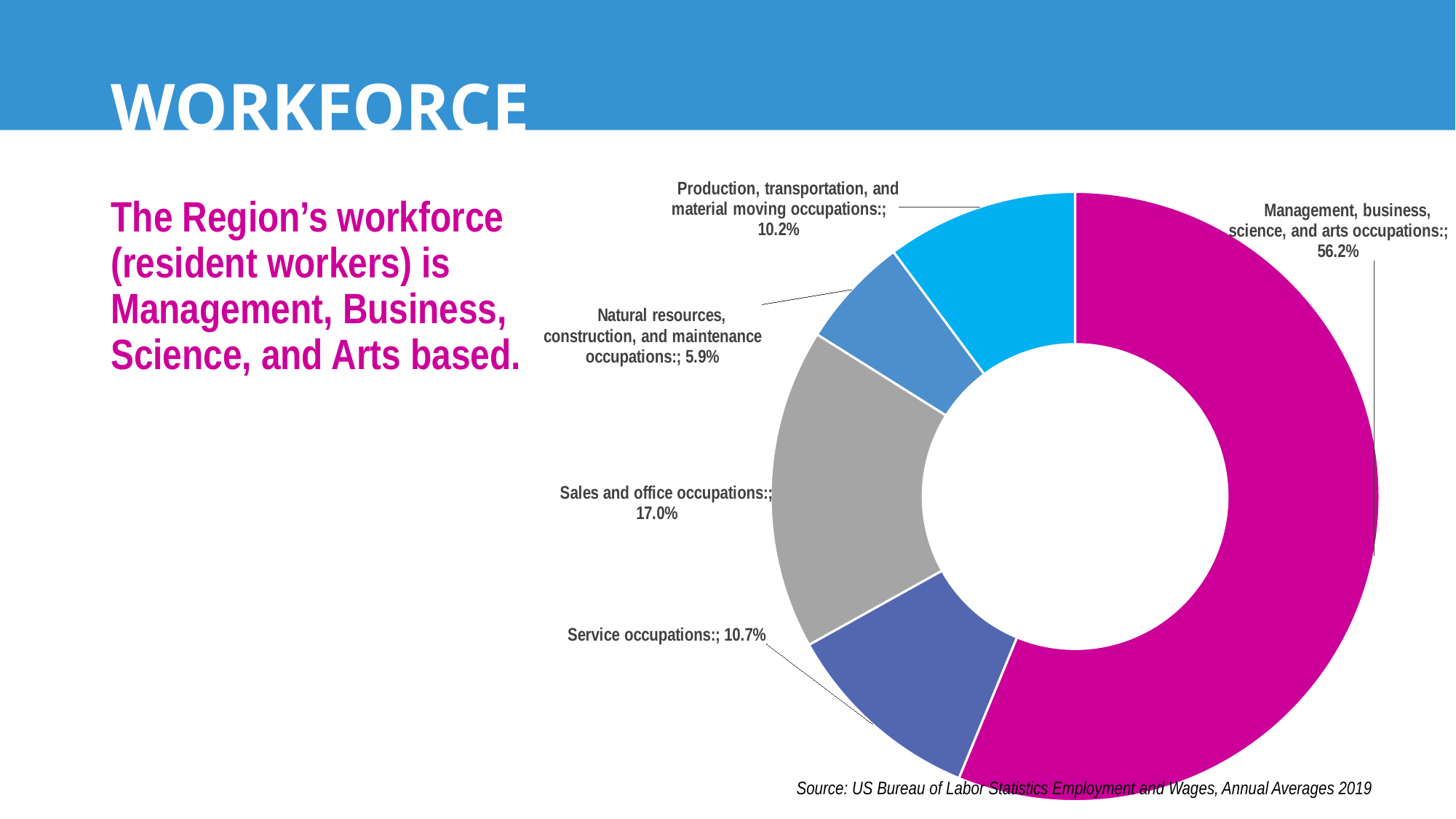
Which occupation group has the largest share of the workforce? Management, business, science, and arts occupations What share of the workforce is in Natural resources, construction, and maintenance occupations? 5.9% Which occupation group has the smallest share of the workforce? Natural resources, construction, and maintenance occupations What share of the workforce is in Service occupations? 10.7% Which has a larger share: Sales and office occupations or Service occupations? Sales and office occupations What kind of chart is shown on the slide? Doughnut (pie) chart What share of the workforce is in Sales and office occupations? 17.0% What share of the workforce is in Management, business, science, and arts occupations? 56.2% What is the difference in percentage points between Management, business, science, and arts occupations and Sales and office occupations? 39.2 What share of the workforce is in Production, transportation, and material moving occupations? 10.2% What colour is the slice for Sales and office occupations? Grey How many occupation groups are shown in the chart? 5